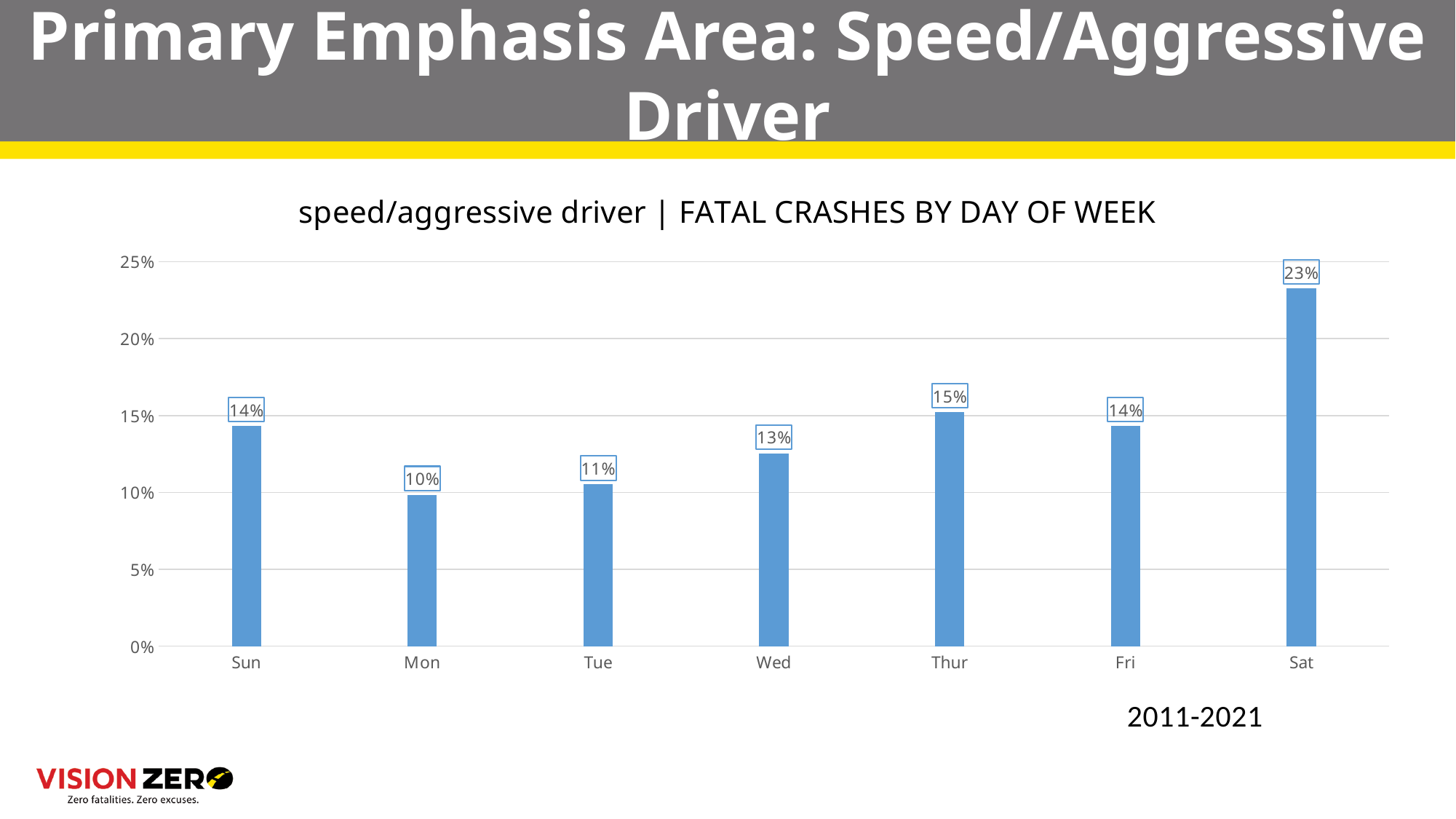
What kind of chart is shown on the slide? Bar chart What is the title of the chart? speed/aggressive driver | FATAL CRASHES BY DAY OF WEEK How many days of the week are shown on the x axis? 7 What is the value for Mon? 10% Which day has the highest share of fatal crashes? Sat Which is larger, the value for Tue or the value for Thur? Thur What is the value for Thur? 15% What is the value for Sat? 23% Is the value for Sat greater or less than 20%? greater What is the difference between the values for Sat and Mon? 13% Which day has the lowest share of fatal crashes? Mon What is the value for Wed? 13%